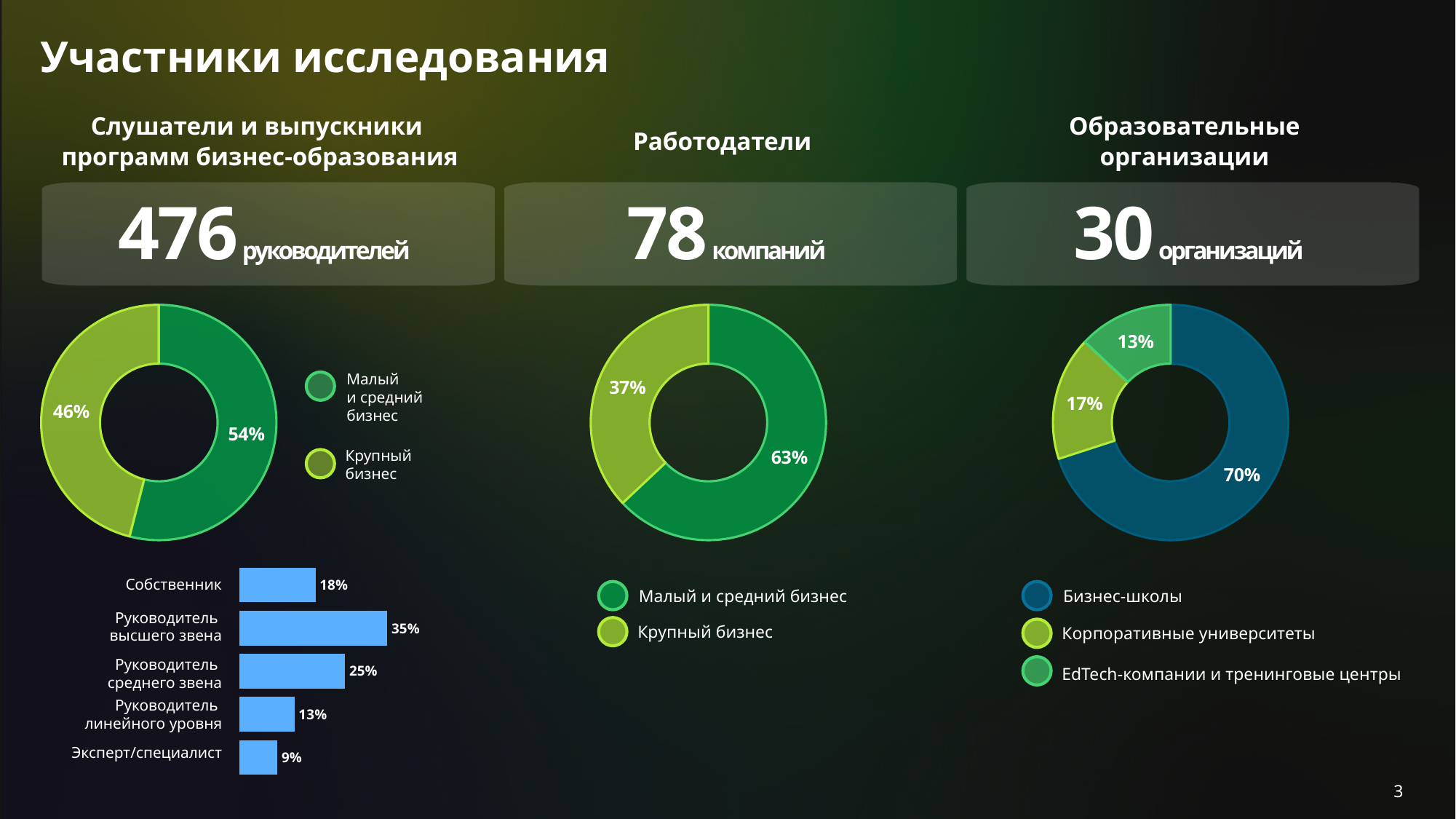
In the donut chart under "Слушатели и выпускники программ бизнес-образования", what share is "Крупный бизнес"? 46% How many categories does the legend of the donut chart under "Образовательные организации" list? 3 In the bar chart at the bottom left, which is larger: "Собственник" or "Руководитель среднего звена"? Руководитель среднего звена In the donut chart under "Образовательные организации", what share is "Корпоративные университеты"? 17% In the donut chart under "Слушатели и выпускники программ бизнес-образования", what share is "Малый и средний бизнес"? 54% In the donut chart under "Образовательные организации", which category has the largest share? Бизнес-школы In the donut chart under "Работодатели", what is the difference between the "Малый и средний бизнес" and "Крупный бизнес" shares? 26% In the bar chart at the bottom left, what is the value for "Руководитель высшего звена"? 35% In the bar chart at the bottom left, how many categories are shown? 5 In the donut chart under "Образовательные организации", which category has the smallest share? EdTech-компании и тренинговые центры In the bar chart at the bottom left, which category has the lowest value? Эксперт/специалист